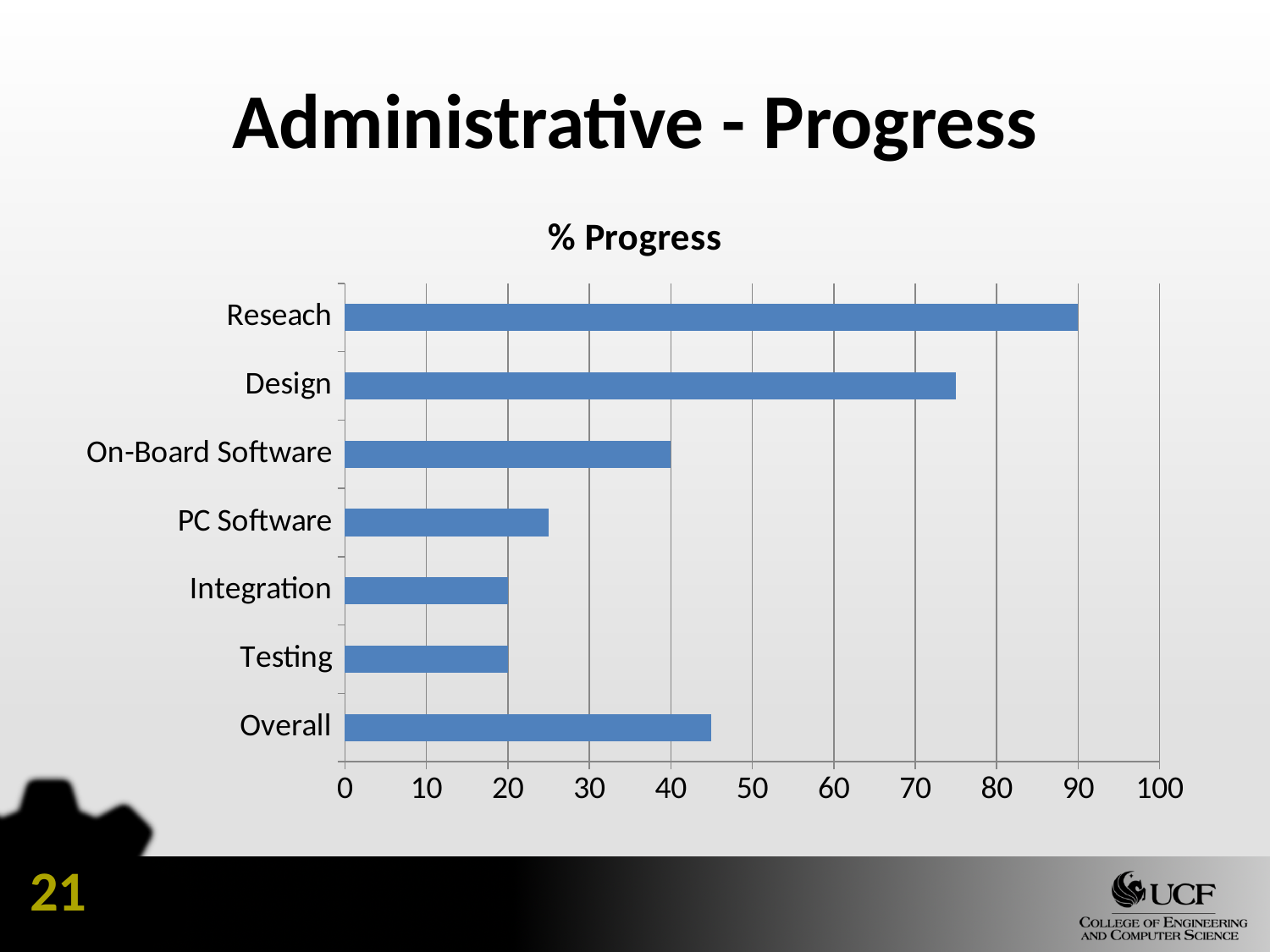
Which has a larger % Progress, Design or On-Board Software? Design Which category has the highest % Progress? Reseach What is the % Progress value for Testing? 20 What is the difference between the % Progress values for Reseach and On-Board Software? 50 What is the % Progress value for Integration? 20 Is the value for Design greater or less than 70? greater What type of chart is shown on the slide? Bar chart What is the % Progress value for Reseach? 90 What is the title of the chart? % Progress How many categories are plotted in the chart? 7 Is the value for Overall greater or less than 50? less What is the % Progress value for On-Board Software? 40